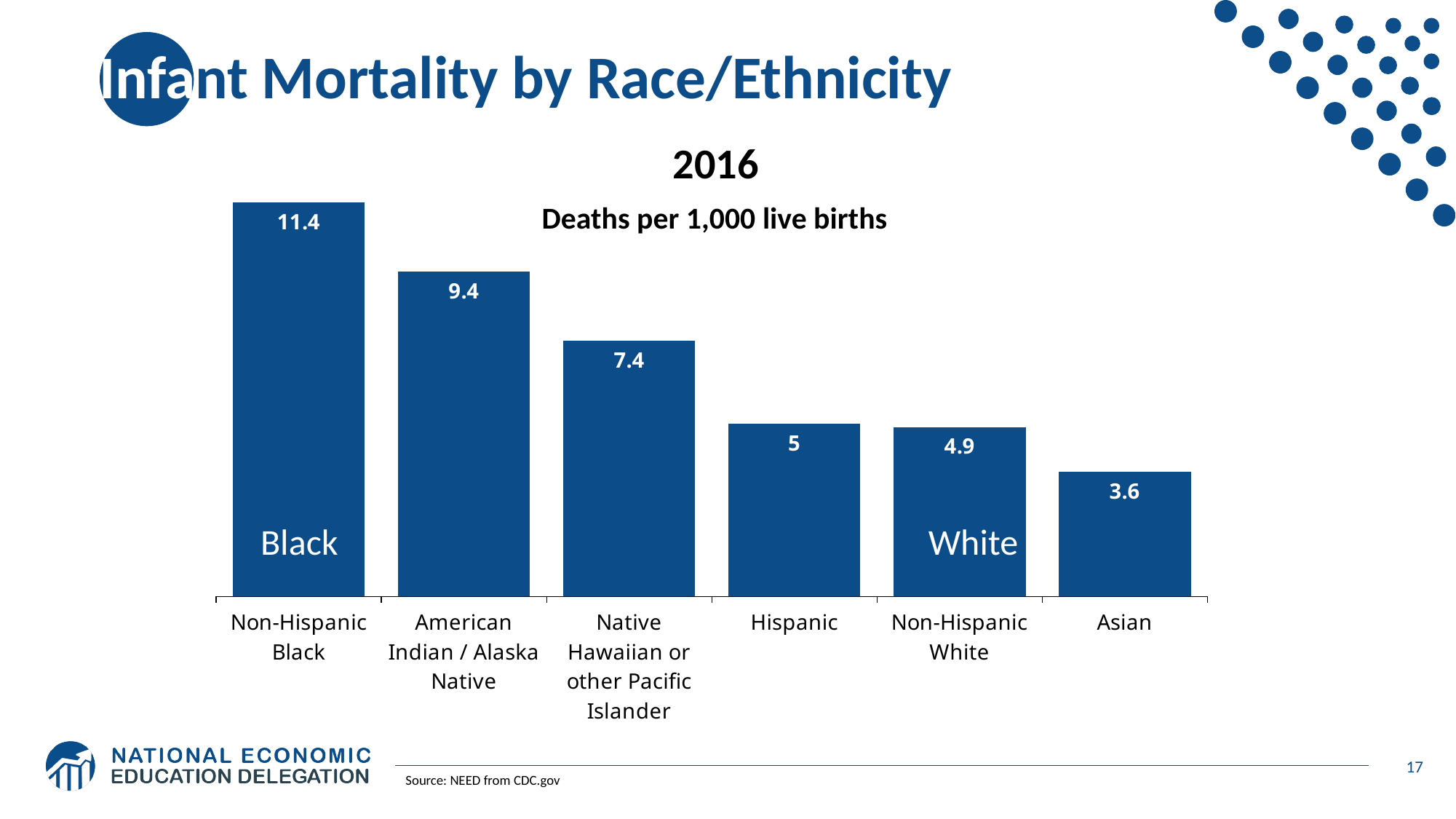
What is the value shown for American Indian / Alaska Native? 9.4 How many race/ethnicity categories are shown in the chart? 6 What is the infant mortality rate for Non-Hispanic Black in 2016? 11.4 What is the difference between the Hispanic and Asian values? 1.4 Which race/ethnicity group has the highest infant mortality rate? Non-Hispanic Black What unit is the infant mortality rate measured in, according to the chart subtitle? Deaths per 1,000 live births Which race/ethnicity group has the lowest infant mortality rate? Asian What is the value shown for Native Hawaiian or other Pacific Islander? 7.4 Which is larger, the value for Hispanic or the value for Non-Hispanic White? Hispanic What kind of chart is shown on the slide? Bar chart What is the difference between the Non-Hispanic Black and Non-Hispanic White values? 6.5 What is the value shown for Asian? 3.6